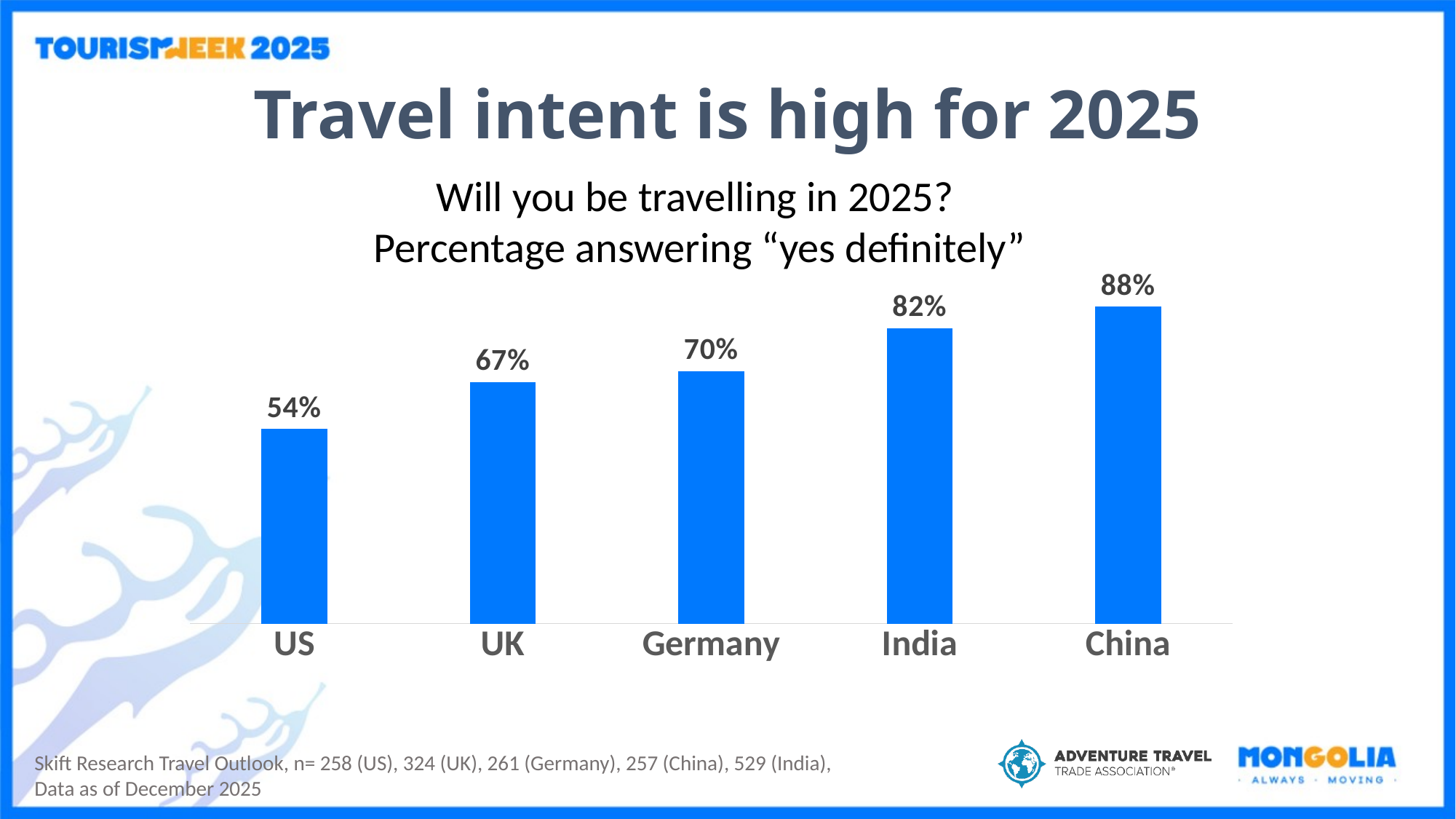
Which country has the highest percentage answering "yes definitely"? China What is the value shown for India? 82% What kind of chart is shown on the slide? Bar chart Which country has the lowest percentage answering "yes definitely"? US What is the difference between the values for China and the US? 34% Which has a higher value, the UK or Germany? Germany What is the difference between the values for India and the UK? 15% How many countries are shown in the chart? 5 What percentage of US respondents answered "yes definitely" to travelling in 2025? 54% What is the value shown for Germany? 70% What question does the chart subtitle say respondents were asked? Will you be travelling in 2025? Do the values rise or fall moving from US to China along the x axis? Rise